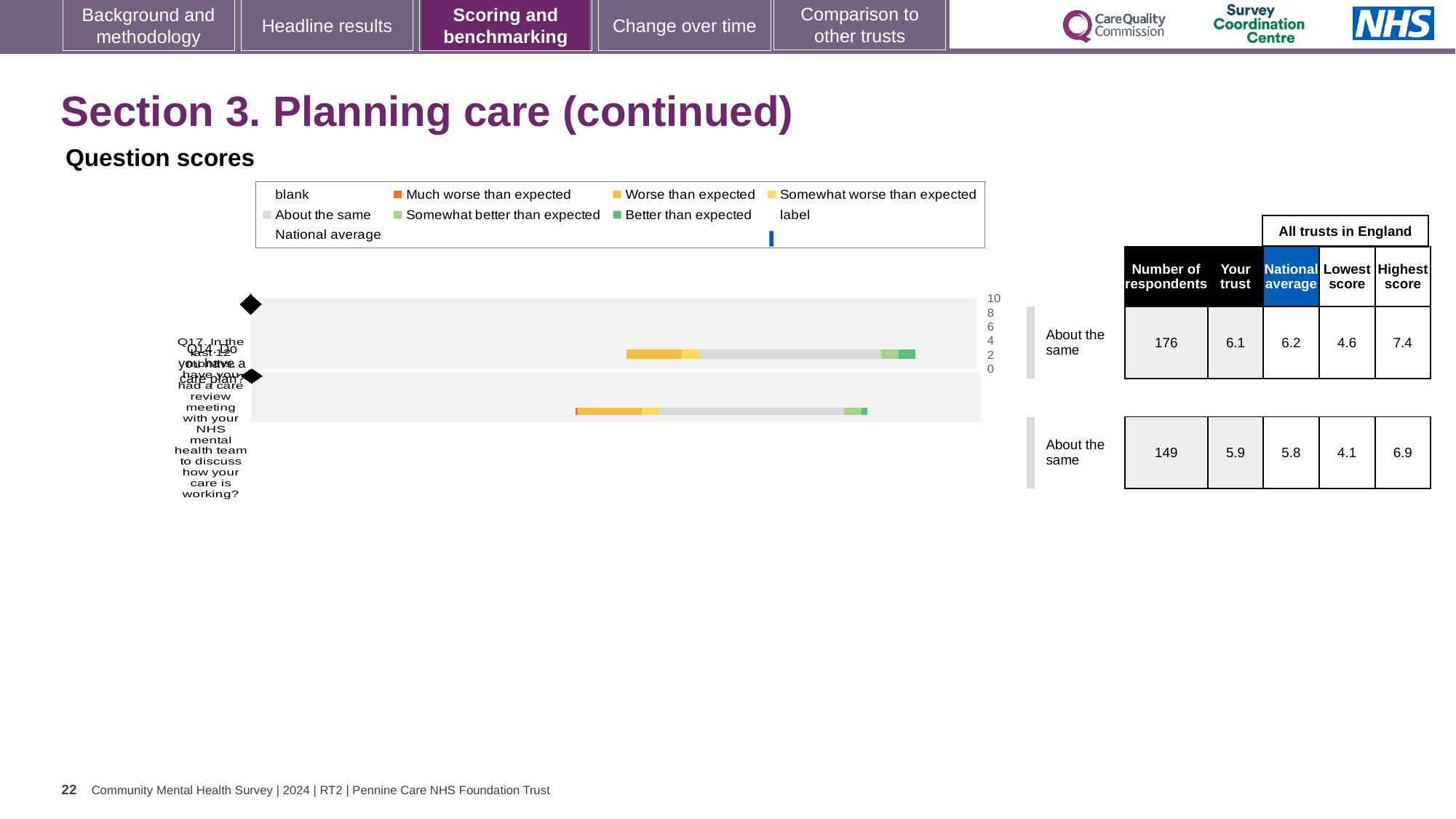
In the table, what is the 'National average' score in the second row? 5.8 What is the highest tick value shown on the chart's axis? 10 What is the difference in number of respondents between the first row (176) and the second row (149)? 27 Which row has the larger 'Your trust' score, the first row or the second row? the first row In the table, what is the 'Lowest score' in the second row? 4.1 How many bars (question rows) are plotted in the chart? 2 In the table, what is the number of respondents in the first row? 176 In the table, what is the 'Your trust' score in the first row? 6.1 What kind of chart is shown on the slide? bar chart Which legend entry is shown in blue? National average In the table, what is the 'Highest score' in the first row? 7.4 In the table, what is the number of respondents in the second row? 149